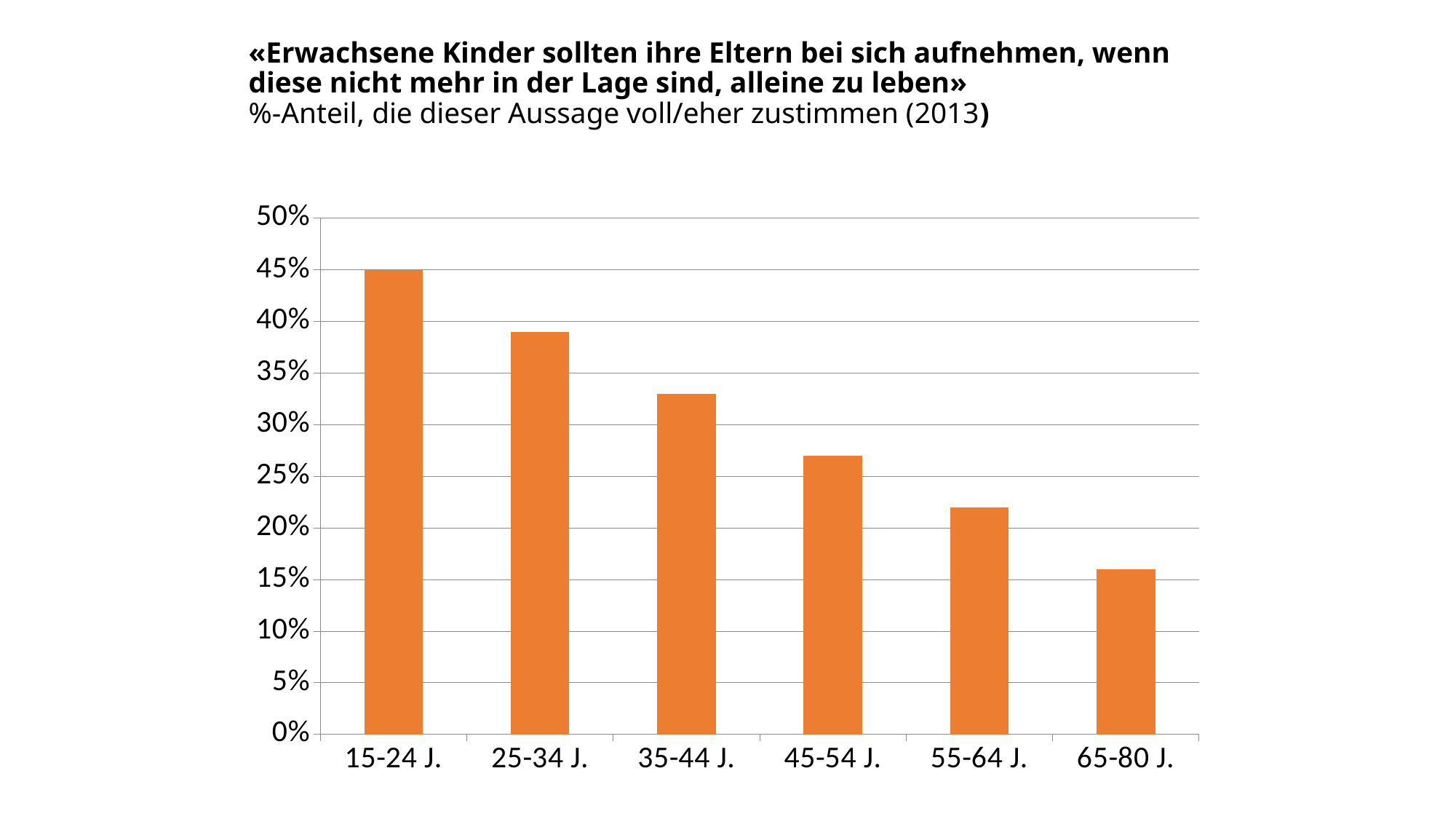
Is the value for 65-80 J. greater or less than 20%? less Which is larger, the value for 25-34 J. or the value for 45-54 J.? 25-34 J. Is the value for 55-64 J. greater or less than 25%? less Which age group has the lowest share agreeing with the statement? 65-80 J. Which age group has the highest share agreeing with the statement? 15-24 J. Is the value for 25-34 J. greater or less than 35%? greater What kind of chart is shown on the slide? bar chart What is the value for the 15-24 J. age group? 45% Do the values rise or fall as age increases along the x axis? fall How many age groups are shown on the x axis? 6